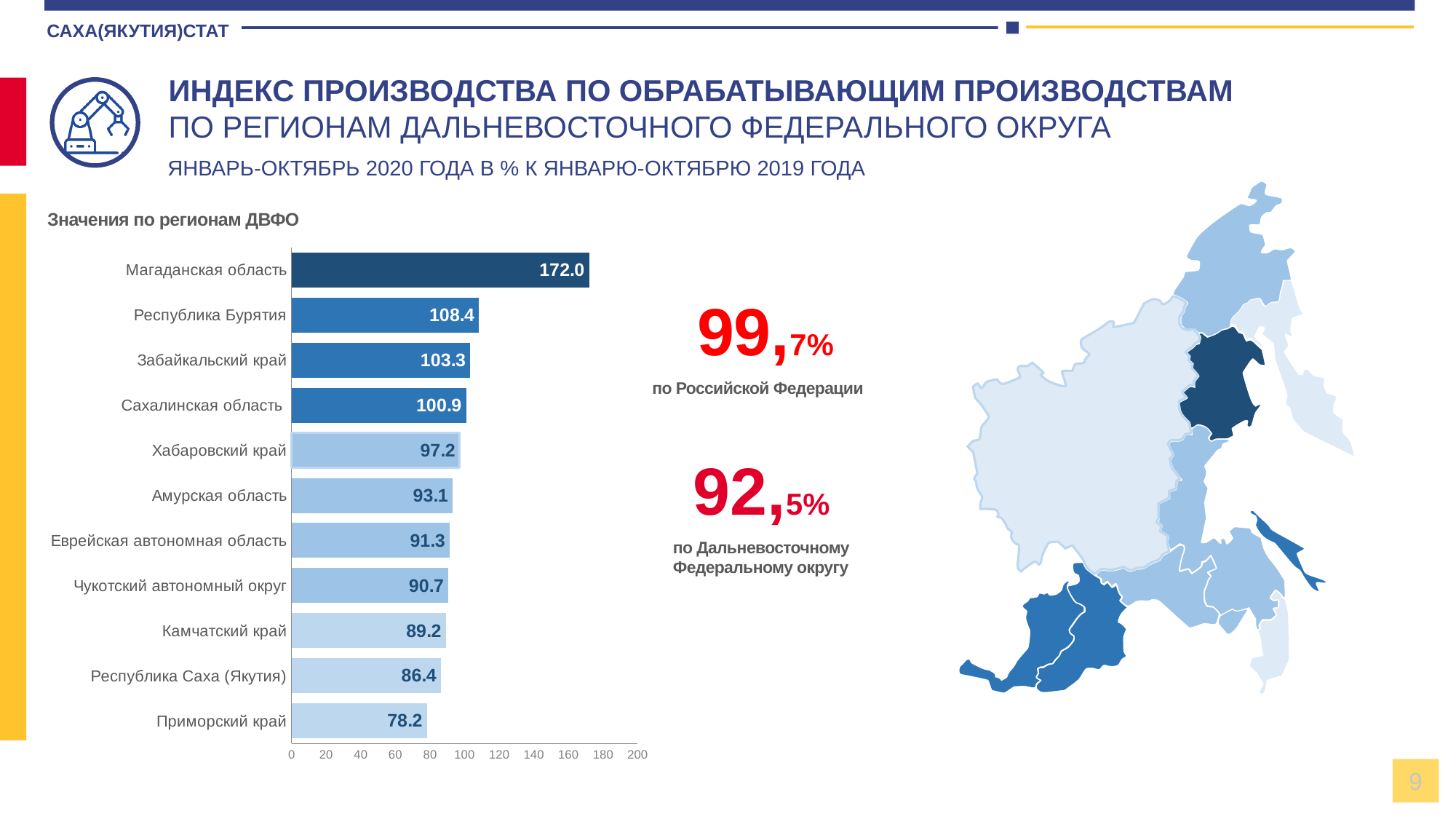
What is the difference between the values for Магаданская область and Республика Бурятия? 63.6 Is the value for Забайкальский край greater or less than 100? greater What is the value for Магаданская область? 172.0 What is the difference between the values for Чукотский автономный округ and Приморский край? 12.5 Which region has the lowest value? Приморский край What is the maximum value shown on the x axis of the bar chart? 200 Which region has the highest value? Магаданская область What is the value for Хабаровский край? 97.2 What kind of chart is used to show the values by region? bar chart What is the value for Республика Саха (Якутия)? 86.4 Which is larger, the value for Амурская область or the value for Камчатский край? Амурская область How many regions are shown in the bar chart? 11